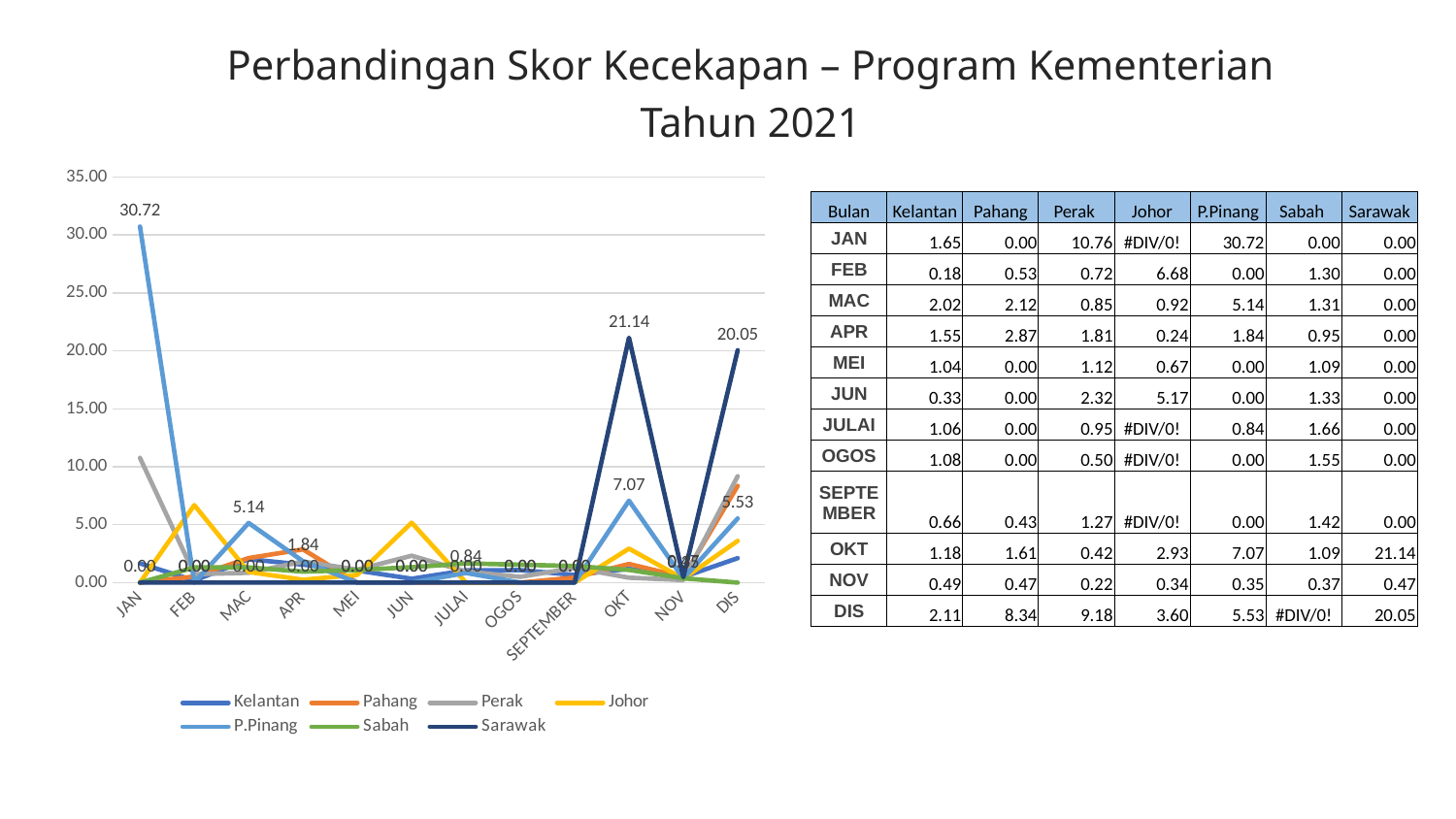
What is the value for P.Pinang in OKT? 7.07 What is the title of the chart? Perbandingan Skor Kecekapan – Program Kementerian Tahun 2021 In which month does P.Pinang reach its highest value? JAN What is the value for P.Pinang in JAN? 30.72 What is the value for Sarawak in OKT? 21.14 How many months are plotted along the x axis of the chart? 12 Which is larger in DIS, the value for Sarawak or the value for P.Pinang? Sarawak How many series does the chart legend list? 7 What is the value for Sarawak in DIS? 20.05 What type of chart is shown on the slide? line chart What is the difference between the Sarawak values in OKT and DIS? 1.09 Is the value for P.Pinang in JAN greater or less than 30.00? greater